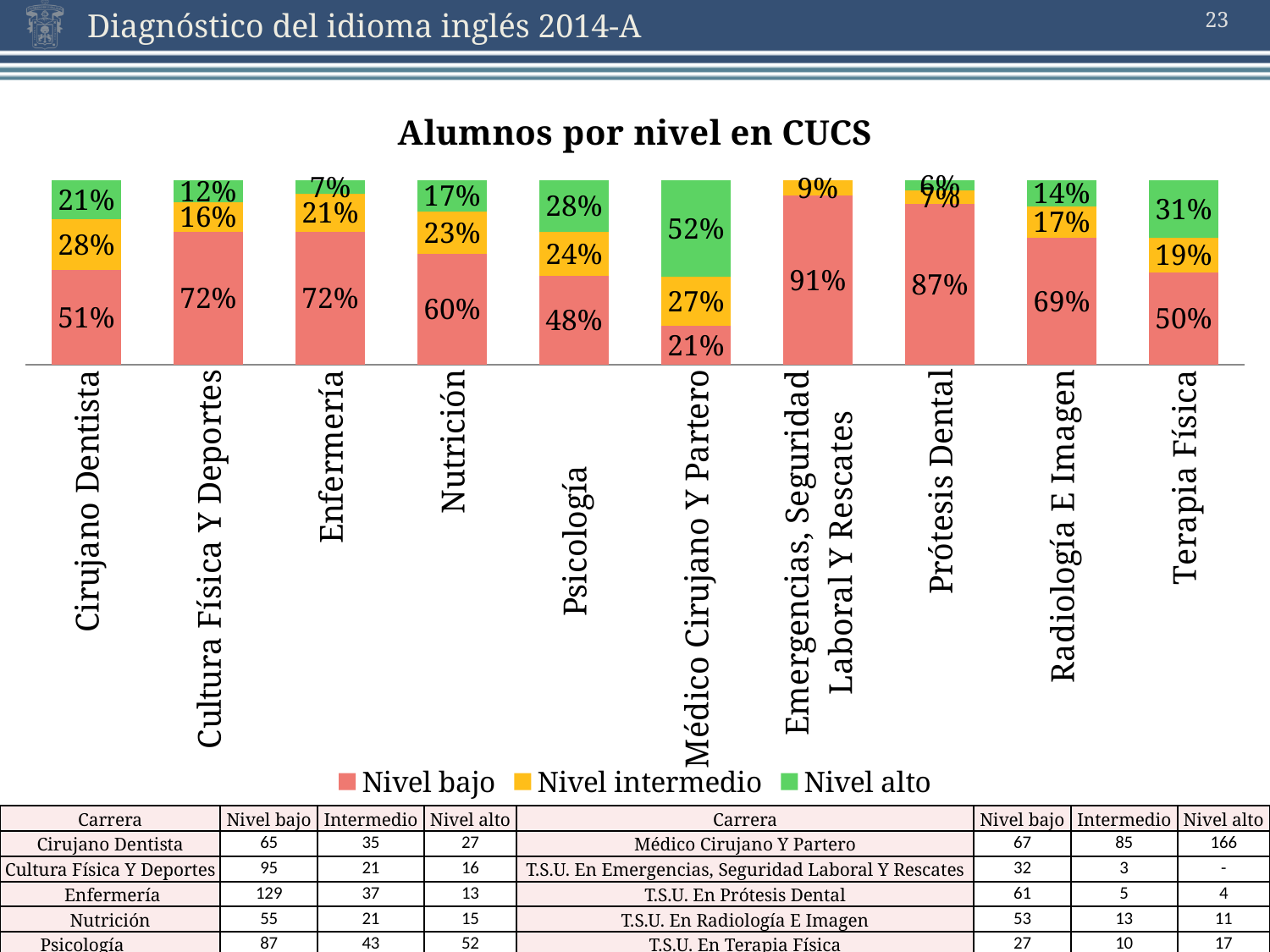
How many series does the chart legend list? 3 Which career has the highest Nivel bajo percentage? Emergencias, Seguridad Laboral Y Rescates What is the difference between the Nivel bajo values for Cultura Física Y Deportes and Psicología? 24% What is the Nivel alto value for Médico Cirujano Y Partero? 52% How many careers (categories) are shown on the x axis of the chart? 10 Which career has the lowest Nivel bajo percentage? Médico Cirujano Y Partero What is the title of the chart? Alumnos por nivel en CUCS Which is larger, the Nivel alto value for Terapia Física or for Radiología E Imagen? Terapia Física What kind of chart is shown on the slide? Stacked bar chart Which legend entry is shown in green? Nivel alto What is the Nivel intermedio value for Nutrición? 23% What is the Nivel bajo value for Cirujano Dentista? 51%